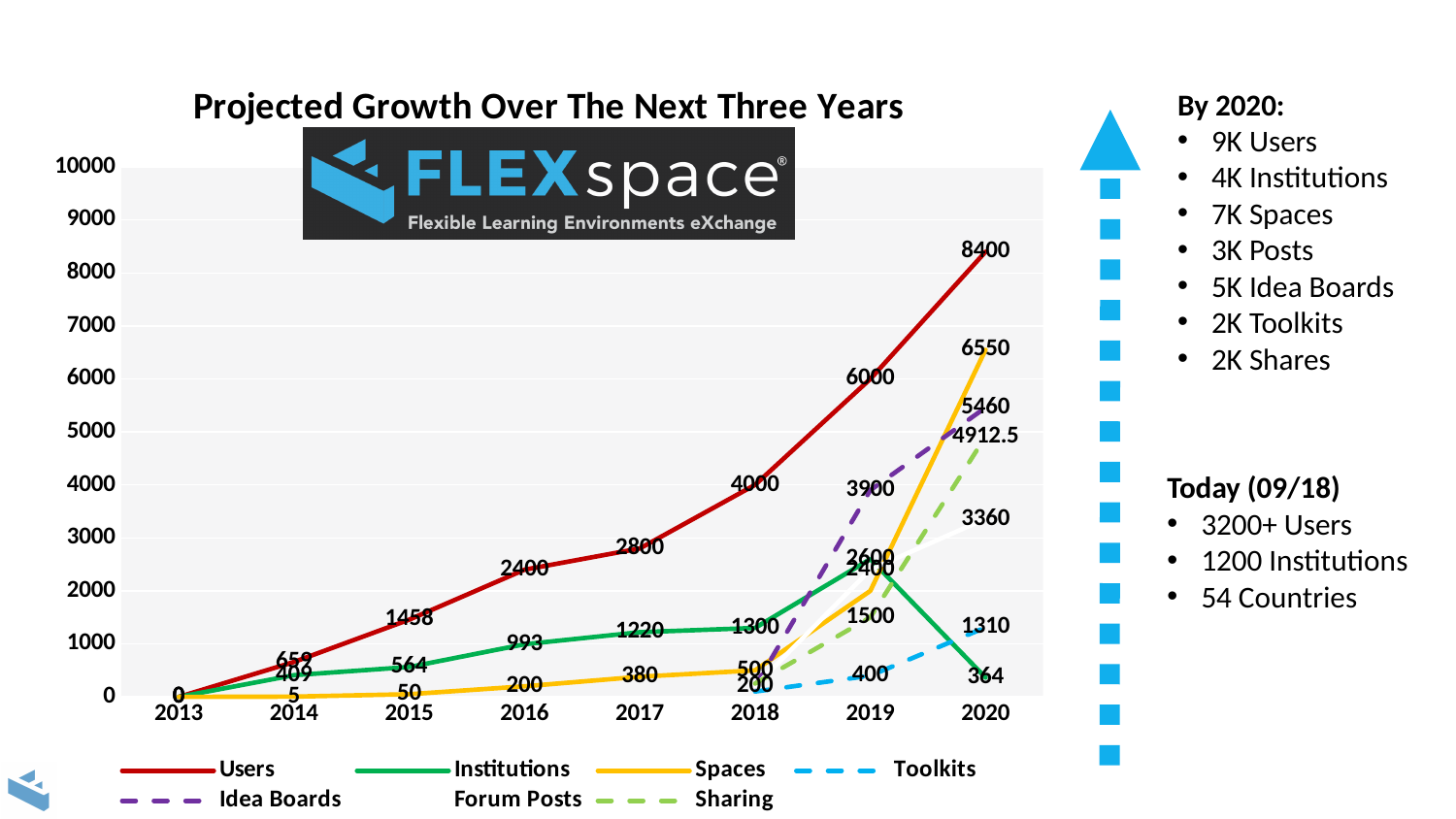
How many years are shown on the x axis? 8 How many series does the legend list? 7 What is the value for Spaces in 2020? 6550 What is the value for Users in 2016? 2400 What is the difference between the Users values for 2020 and 2019? 2400 What is the value for Idea Boards in 2020? 5460 What type of chart is shown on the slide? line chart What is the value for Users in 2020? 8400 Which series has the highest value in 2020? Users What is the title of the chart? Projected Growth Over The Next Three Years What is the value for Toolkits in 2020? 1310 Which is larger in 2020, Spaces or Idea Boards? Spaces